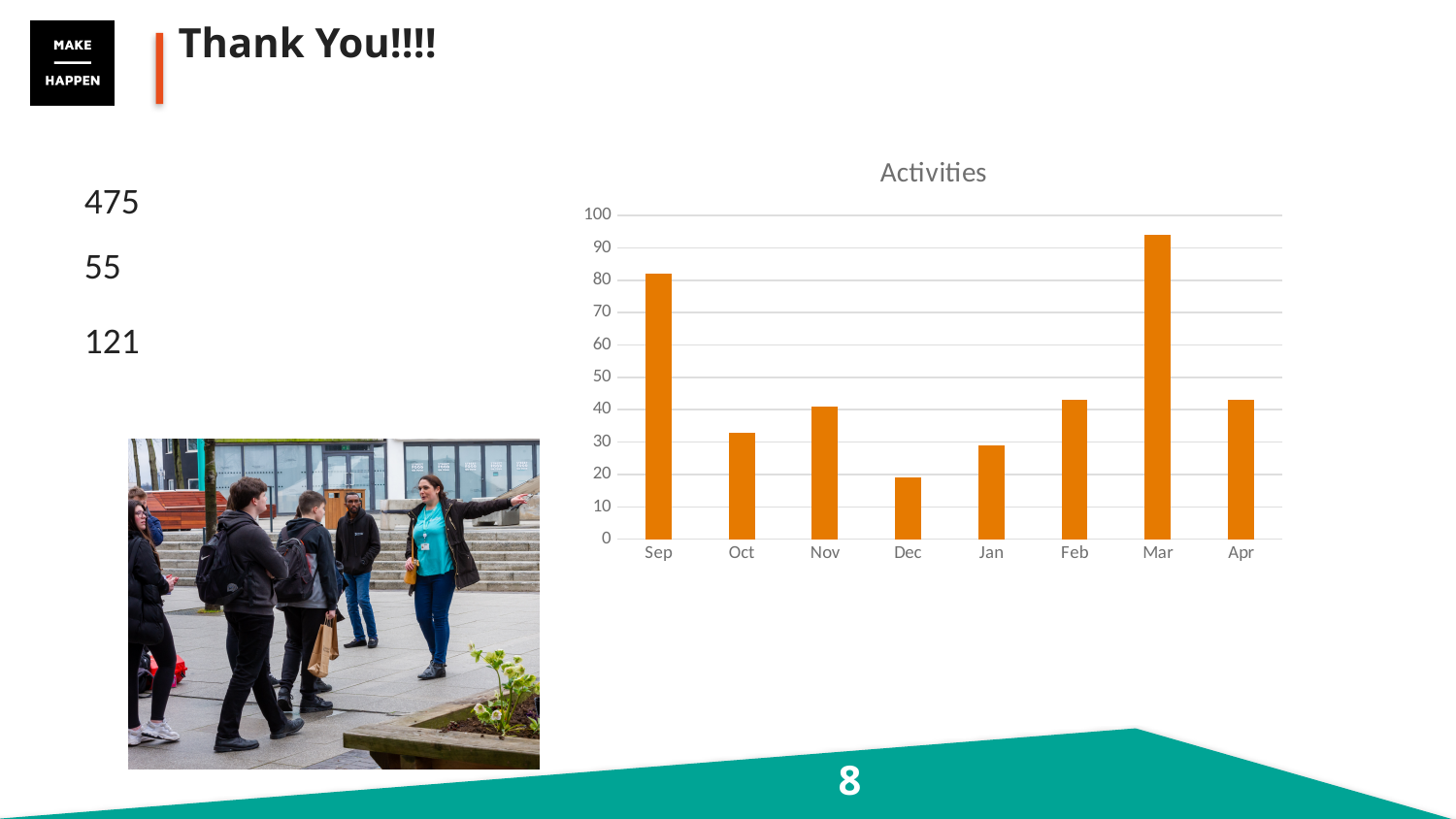
Which month has the highest value in the Activities chart? Mar What kind of chart is shown on the slide? bar chart Do the values rise or fall from Dec to Mar? rise Which is larger, the value for Sep or the value for Oct? Sep How many months are shown on the x axis of the Activities chart? 8 Which is larger, the value for Nov or the value for Dec? Nov Is the value for Mar greater or less than 90? greater What is the title of the chart? Activities Which month has the lowest value in the Activities chart? Dec